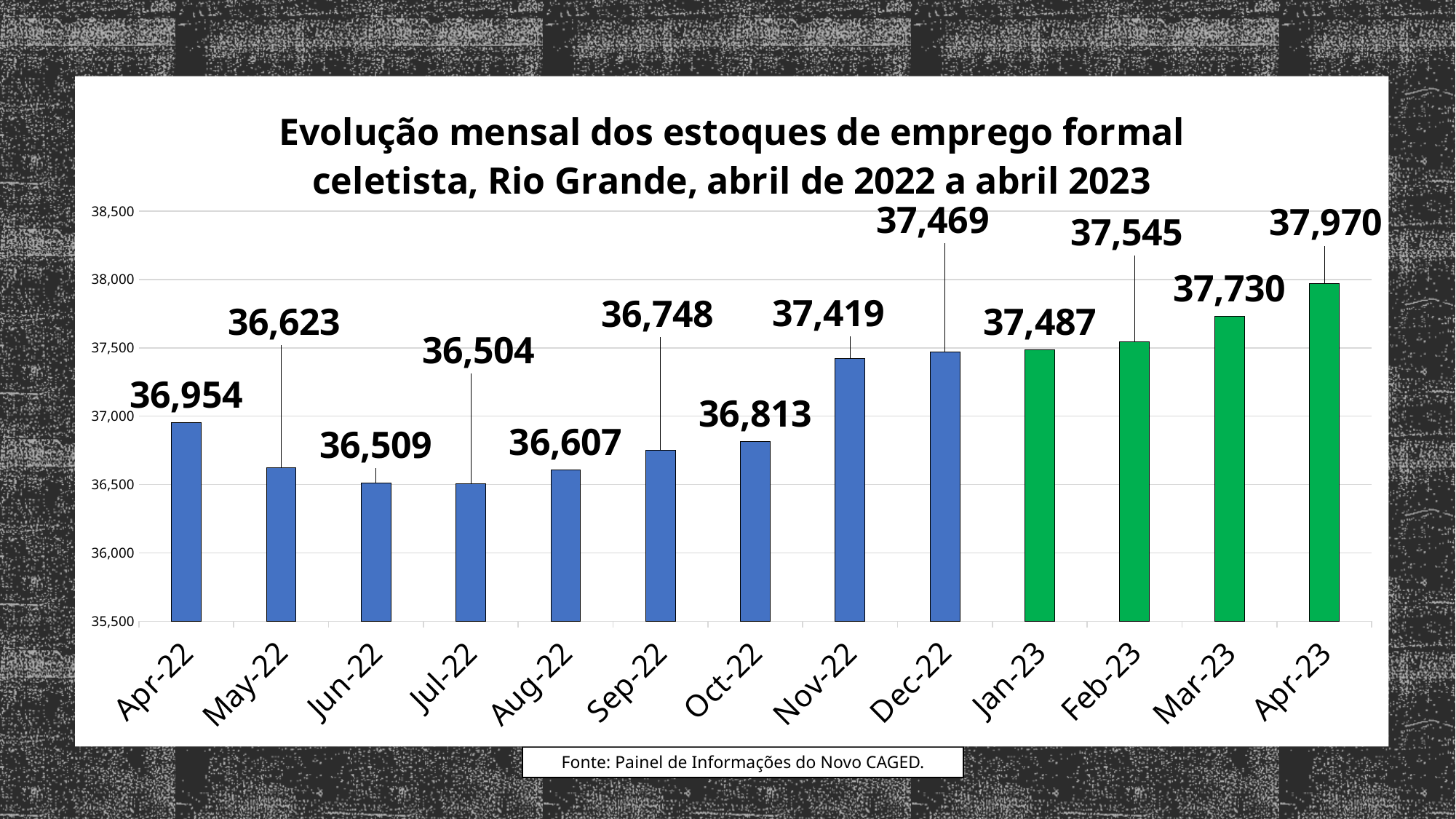
Do the values generally rise or fall from Jul-22 to Apr-23? rise What is the value for Feb-23? 37,545 What is the value for Nov-22? 37,419 Which is larger, the value for Sep-22 or the value for Oct-22? Oct-22 What is the difference between the values for Nov-22 and Oct-22? 606 What is the difference between the values for Apr-23 and Apr-22? 1,016 What kind of chart is shown on the slide? bar chart What is the value for Apr-22? 36,954 Which month has the highest value? Apr-23 Which month has the lowest value? Jul-22 Is the value for Dec-22 greater or less than 37,000? greater How many months are shown on the x axis? 13